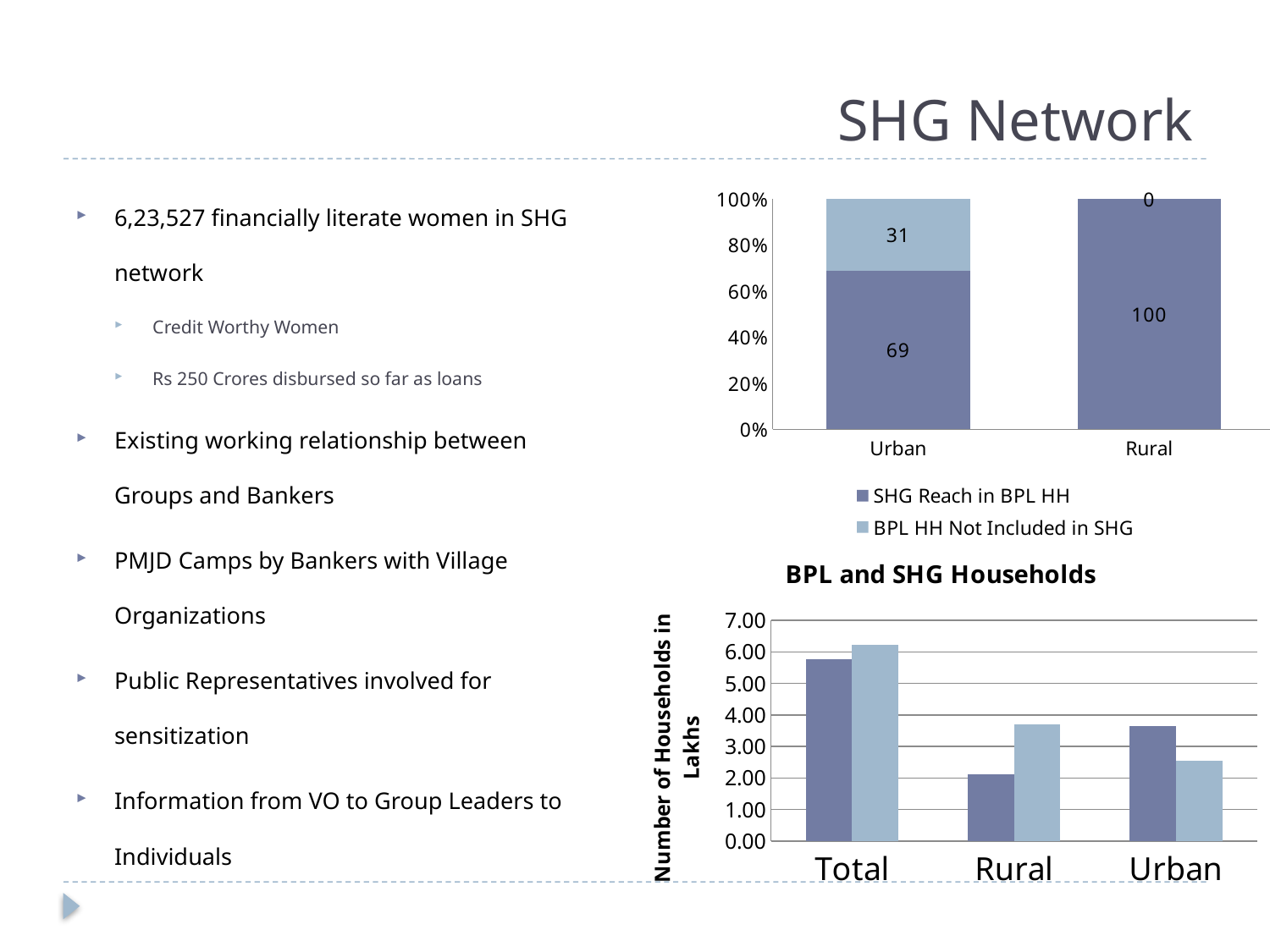
In the 'BPL and SHG Households' chart, is the dark blue bar for Rural greater or less than 3.00? less In the top chart, what is the value of BPL HH Not Included in SHG for Rural? 0 In the top chart, how many series does the legend list? 2 In the top chart, what is the value of SHG Reach in BPL HH for Rural? 100 What kind of chart is the 'BPL and SHG Households' chart? Bar chart In the top chart, which category has the higher value for SHG Reach in BPL HH, Urban or Rural? Rural In the top chart, what is the value of BPL HH Not Included in SHG for Urban? 31 What is the y-axis label of the 'BPL and SHG Households' chart? Number of Households in Lakhs How many categories are shown on the x axis of the 'BPL and SHG Households' chart? 3 In the top chart, what is the difference between SHG Reach in BPL HH for Urban and for Rural? 31 In the 'BPL and SHG Households' chart, is the light blue bar for Total greater or less than 6.00? greater In the top chart, what is the value of SHG Reach in BPL HH for Urban? 69